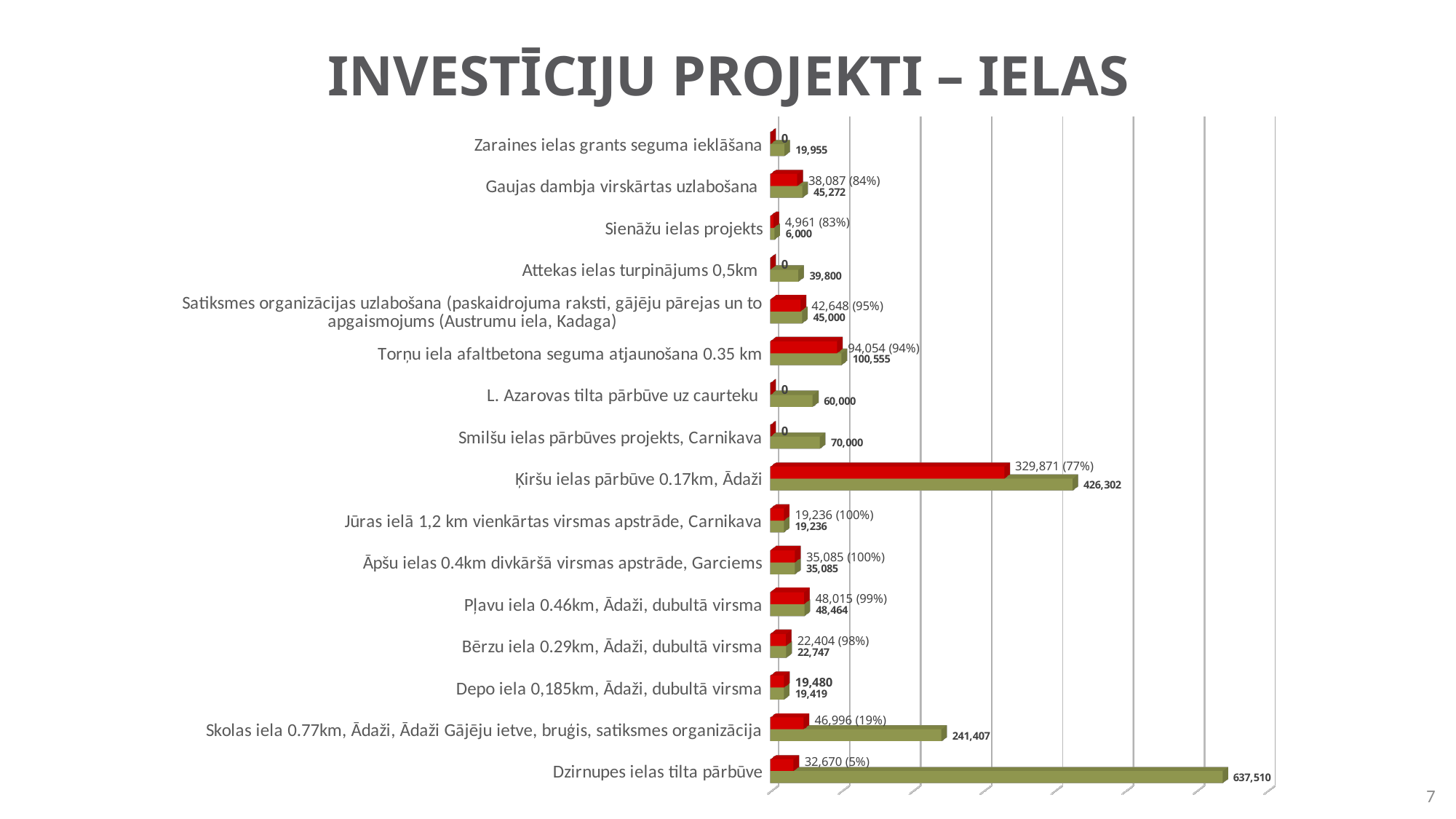
Which category has the longest green bar? Dzirnupes ielas tilta pārbūve What is the title of the slide? INVESTĪCIJU PROJEKTI – IELAS Which green bar is larger: Ķiršu ielas pārbūve 0.17km, Ādaži or Skolas iela 0.77km, Ādaži? Ķiršu ielas pārbūve 0.17km, Ādaži How many categories are shown in the chart? 16 What is the value of the green bar for Dzirnupes ielas tilta pārbūve? 637,510 What percentage is shown next to the red bar for Skolas iela 0.77km, Ādaži? 19% What is the value of the red bar for Ķiršu ielas pārbūve 0.17km, Ādaži? 329,871 What type of chart is shown on the slide? Bar chart What is the value of the green bar for Torņu iela afaltbetona seguma atjaunošana 0.35 km? 100,555 Which category has the smallest green bar value? Sienāžu ielas projekts Which category has the longest red bar? Ķiršu ielas pārbūve 0.17km, Ādaži What is the difference between the green and red bar values for Skolas iela 0.77km, Ādaži? 194,411